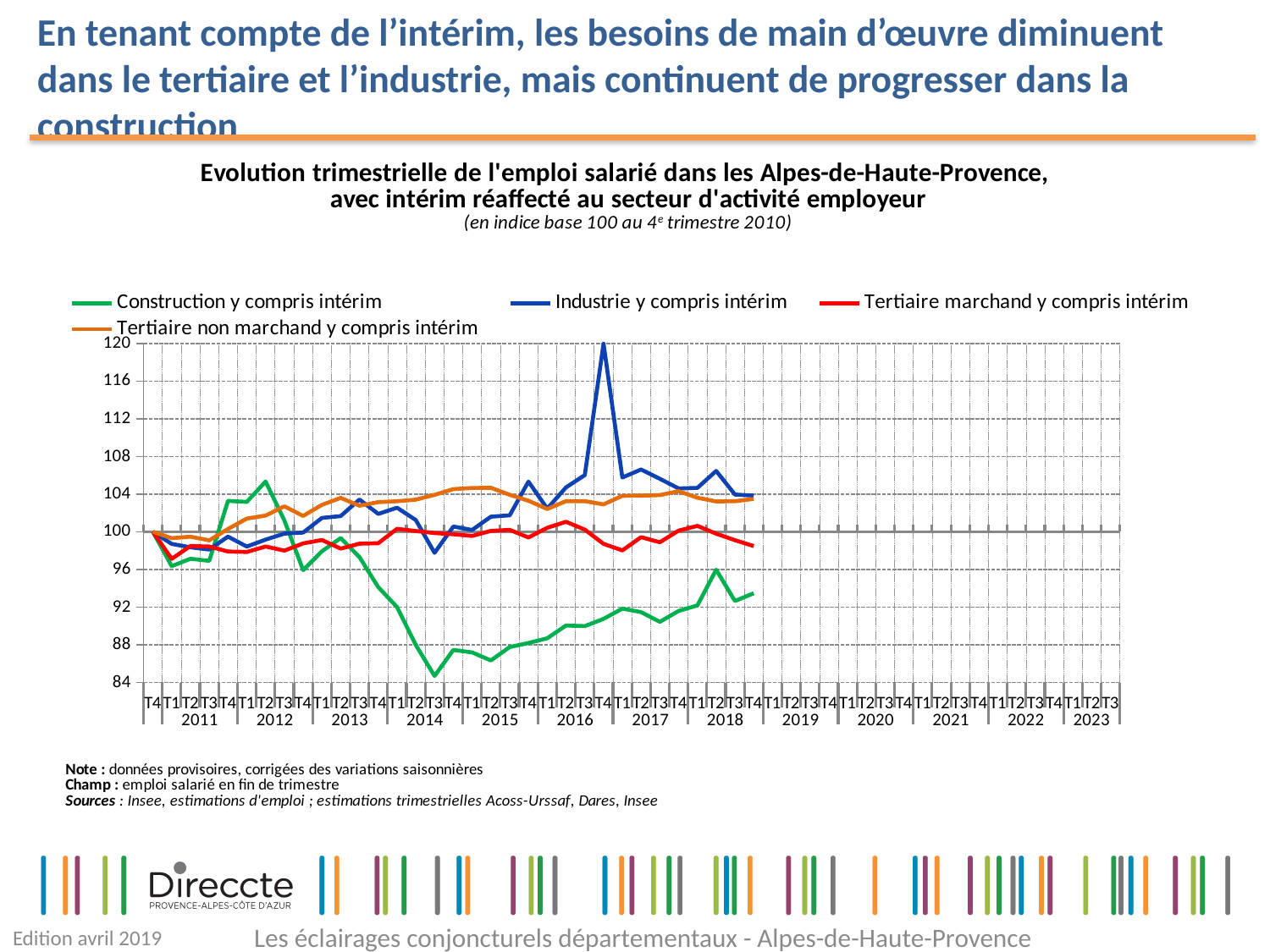
Is the value for 'Construction y compris intérim' at T2 2018 greater or less than 92? greater Is the value for 'Construction y compris intérim' at T3 2014 greater or less than 88? less Which series has the highest value at T4 2016? Industrie y compris intérim Is the value for 'Tertiaire non marchand y compris intérim' at T4 2018 greater or less than 100? greater How many series does the legend list? 4 What kind of chart is shown on the slide? line chart Which colour is used for the 'Construction y compris intérim' series? green Which series has the lowest value at T4 2018? Construction y compris intérim Does the 'Construction y compris intérim' series rise or fall between T2 2012 and T3 2014? fall At T4 2018, which is higher: 'Industrie y compris intérim' or 'Tertiaire marchand y compris intérim'? Industrie y compris intérim What is the base period of the index used in the chart, according to the subtitle? 4e trimestre 2010